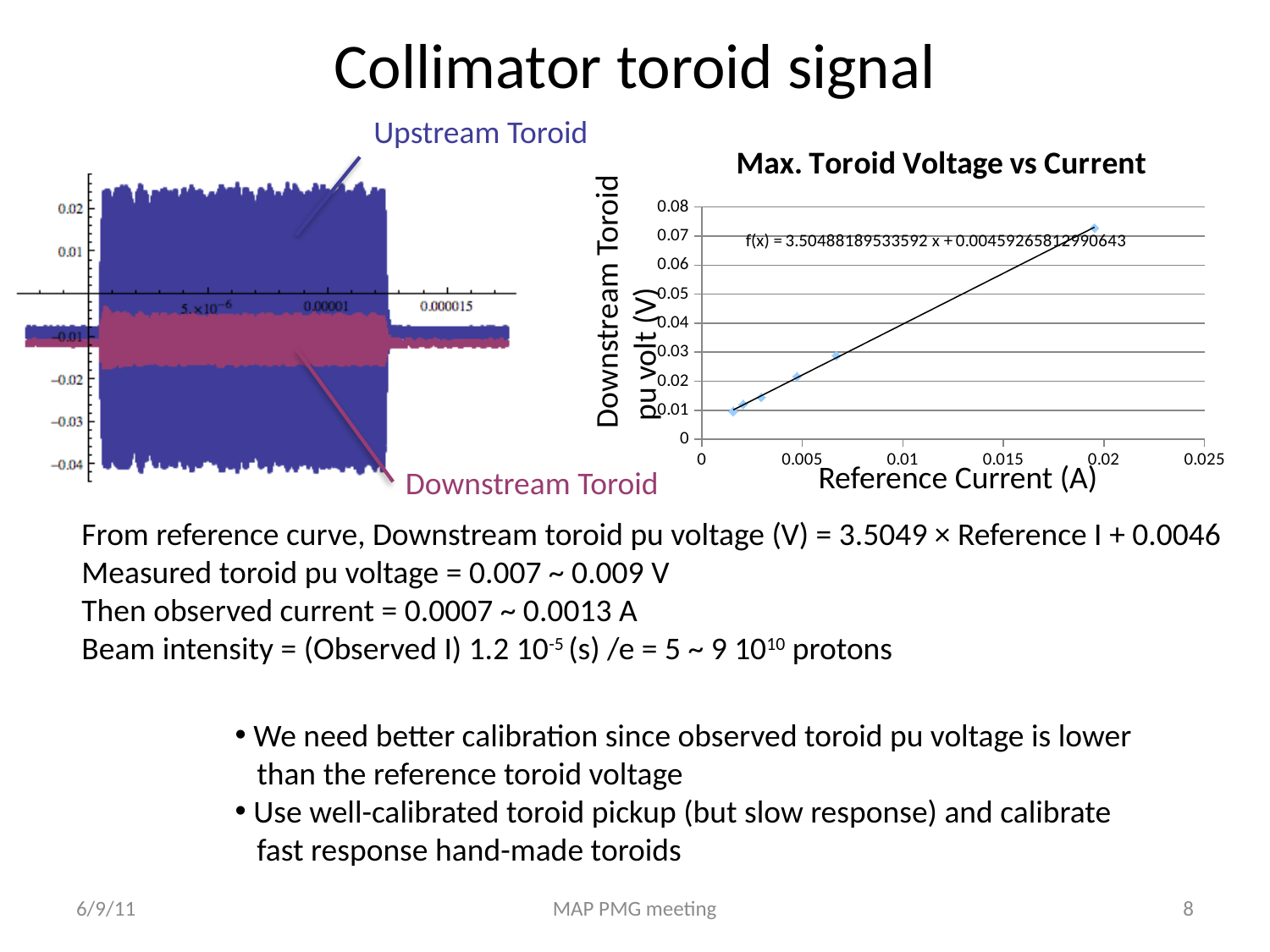
What is the title of the chart on the right side of the slide? Max. Toroid Voltage vs Current In the 'Max. Toroid Voltage vs Current' chart, what is the intercept of the fitted line f(x) shown on the chart? 0.00459265812990643 What kind of chart is the 'Max. Toroid Voltage vs Current' chart on the right? Scatter chart with a linear trendline In the 'Max. Toroid Voltage vs Current' chart, what is the label of the horizontal axis? Reference Current (A) In the 'Max. Toroid Voltage vs Current' chart, is the voltage of the data point at the lowest reference current greater or less than 0.02 V? less In the 'Max. Toroid Voltage vs Current' chart, is the voltage of the data point at the highest reference current (near 0.02 A) greater or less than 0.06 V? greater In the 'Max. Toroid Voltage vs Current' chart, do the voltage values rise or fall as the reference current increases? Rise In the 'Max. Toroid Voltage vs Current' chart, what is the maximum value shown on the horizontal axis? 0.025 In the 'Max. Toroid Voltage vs Current' chart, what is the maximum value shown on the vertical axis? 0.08 In the left-hand signal plot, which toroid signal is labeled in pink/red? Downstream Toroid In the 'Max. Toroid Voltage vs Current' chart, what is the slope of the fitted line f(x) shown on the chart? 3.50488189533592 In the 'Max. Toroid Voltage vs Current' chart, how many data points are plotted? 6